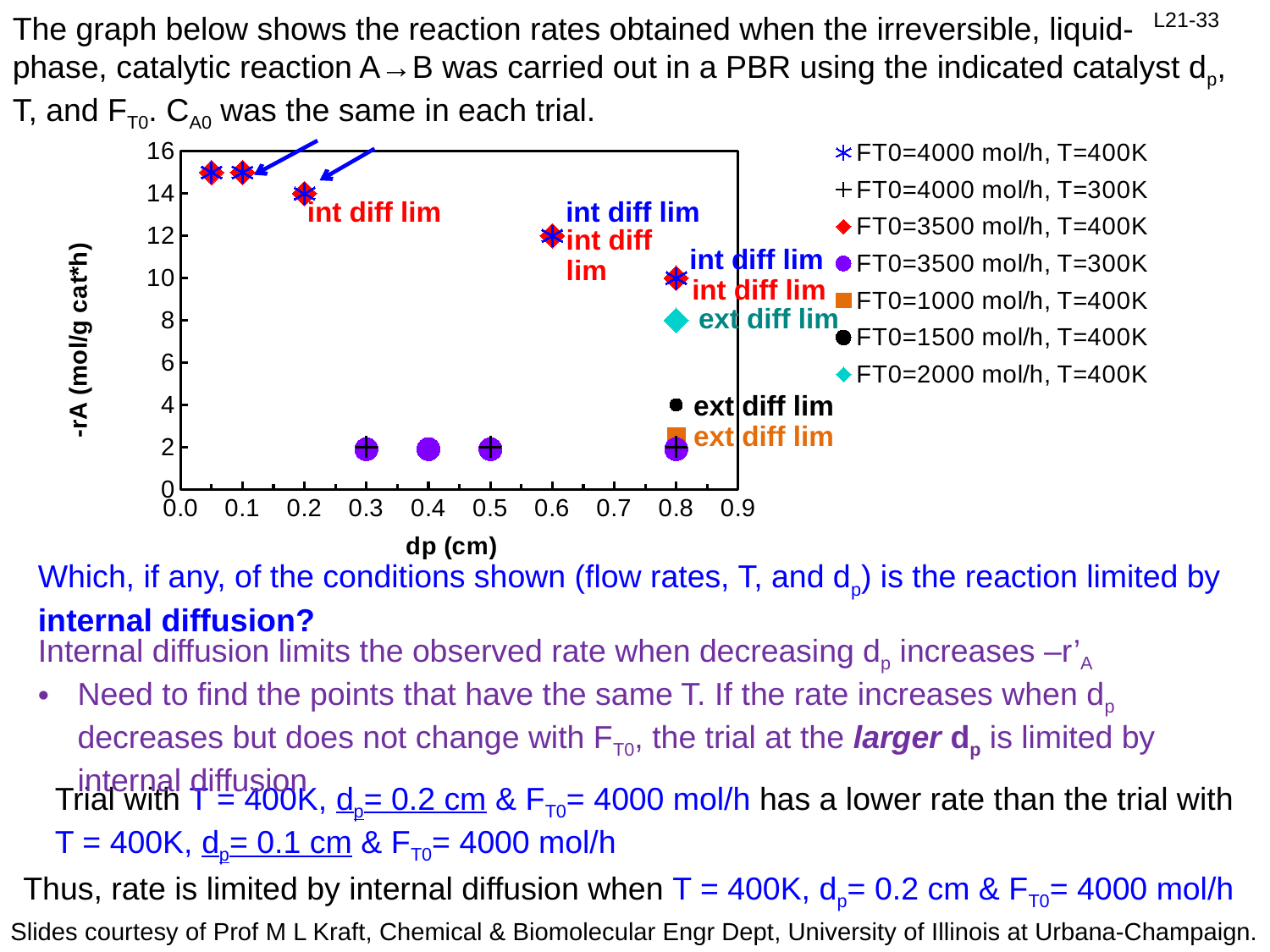
For the FT0=4000 mol/h, T=400K series, does the reaction rate rise or fall as dp increases? fall Is the reaction rate at dp = 0.8 cm for FT0=4000 mol/h, T=400K greater or less than 8? greater What is the title of the y axis of the chart? -rA (mol/g cat*h) What is the reaction rate at dp = 0.6 cm for FT0=4000 mol/h, T=400K? 12 At dp = 0.8 cm, which has the larger reaction rate: FT0=2000 mol/h, T=400K or FT0=1500 mol/h, T=400K? FT0=2000 mol/h, T=400K Is the reaction rate for FT0=2000 mol/h, T=400K greater or less than 6? greater Is the reaction rate for FT0=1500 mol/h, T=400K greater or less than 6? less What is the title of the x axis of the chart? dp (cm) How many series does the chart legend list? 7 What kind of chart is shown on the slide? scatter chart How many data points are plotted for the FT0=3500 mol/h, T=300K series? 4